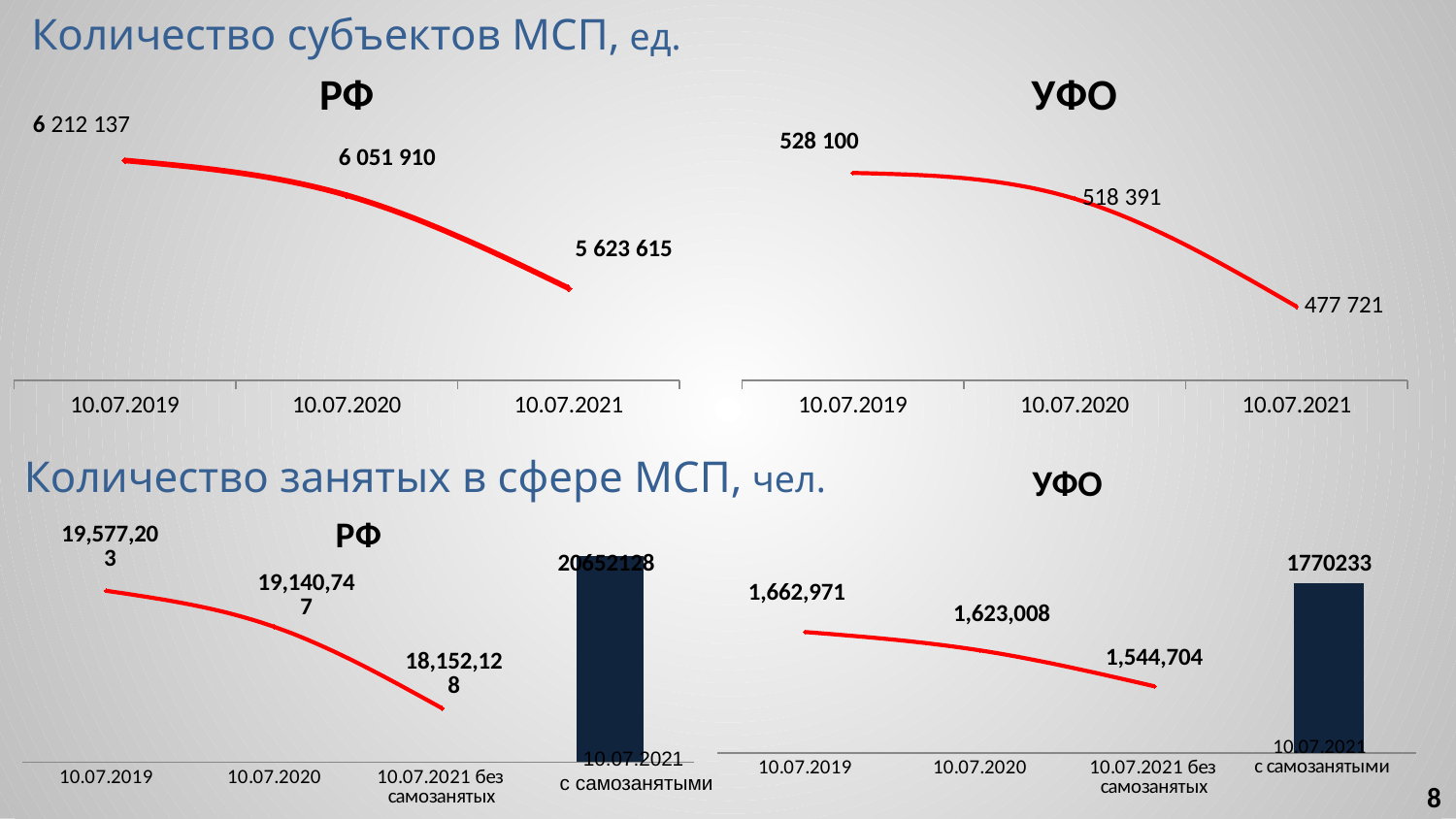
In the bottom-left chart (Количество занятых в сфере МСП, РФ), what is the value of the bar for 10.07.2021 с самозанятыми? 20652128 In the top-left chart (Количество субъектов МСП, РФ), what is the difference between the 10.07.2019 and 10.07.2021 values? 588 522 In the bottom-right chart (Количество занятых в сфере МСП, УФО), which is larger: the value for 10.07.2019 or the bar for 10.07.2021 с самозанятыми? 10.07.2021 с самозанятыми In the bottom-left chart (Количество занятых в сфере МСП, РФ), what is the value for 10.07.2020? 19,140,747 How many dates are shown on the x axis of the top-left chart (Количество субъектов МСП, РФ)? 3 In the top-right chart (Количество субъектов МСП, УФО), do the values rise or fall from 10.07.2019 to 10.07.2021? fall In the bottom-right chart (Количество занятых в сфере МСП, УФО), what is the value for 10.07.2021 без самозанятых? 1,544,704 In the top-right chart (Количество субъектов МСП, УФО), what is the value for 10.07.2020? 518 391 In the top-left chart (Количество субъектов МСП, РФ), what is the value for 10.07.2019? 6 212 137 In the top-left chart (Количество субъектов МСП, РФ), what is the value for 10.07.2021? 5 623 615 In the top-right chart (Количество субъектов МСП, УФО), what is the difference between the 10.07.2019 and 10.07.2021 values? 50 379 In the top-right chart (Количество субъектов МСП, УФО), which date has the lowest value? 10.07.2021